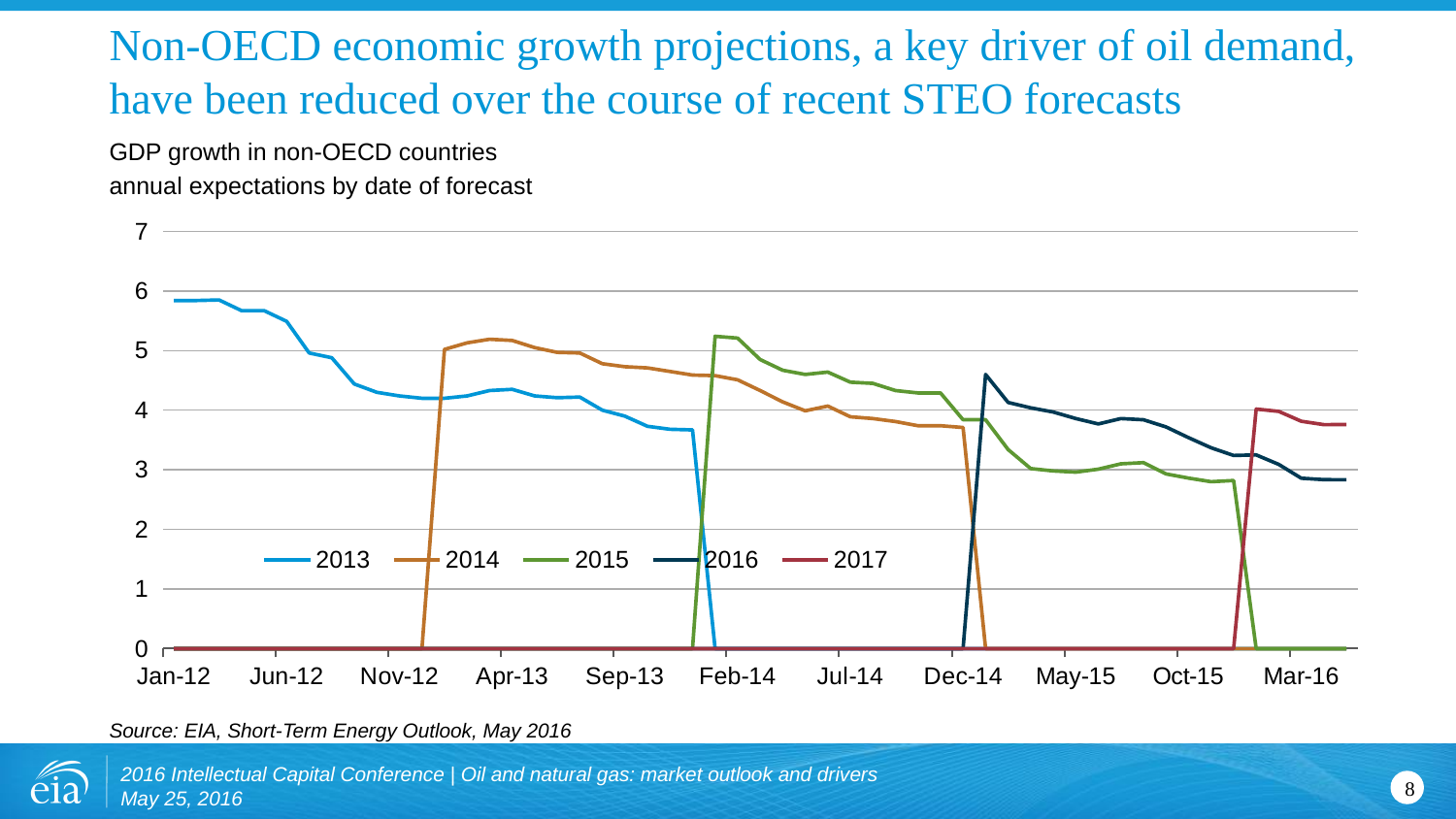
At Mar-16, which series has the larger value, 2016 or 2017? 2017 Is the value of the 2014 series at Apr-13 greater or less than 5? greater Which series reaches the highest value on the chart? 2013 Is the value of the 2013 series at Jan-12 greater or less than 5? greater Which years are listed in the chart legend? 2013, 2014, 2015, 2016, 2017 Is the value of the 2016 series at Mar-16 greater or less than 3? less Does the 2013 series rise or fall between Jan-12 and Sep-13? fall Does the 2014 series rise or fall between Apr-13 and Dec-14? fall What is the chart's title? GDP growth in non-OECD countries annual expectations by date of forecast What kind of chart is shown on the slide? line chart How many series does the legend list? 5